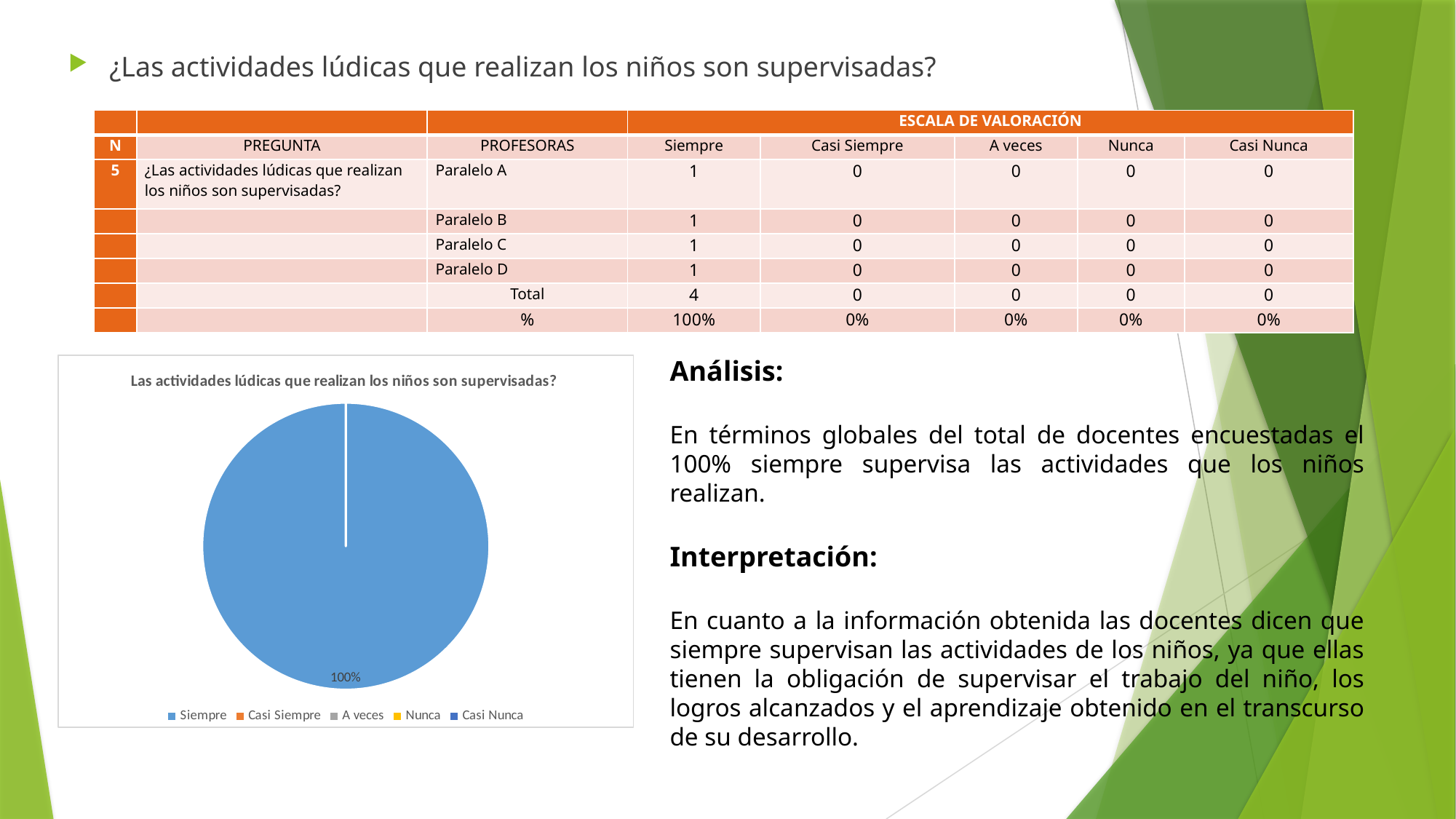
How many entries does the pie chart's legend list? 5 What percentage label is printed on the pie chart? 100% Which category has the largest slice in the pie chart? Siempre Is the share for Siempre greater or less than 50%? greater What share of the pie does the Siempre slice represent? 100% What kind of chart is shown on the slide? pie chart How many visible slices does the pie chart have? 1 Which legend entry is shown in blue in the pie chart? Siempre What is the title of the pie chart? Las actividades lúdicas que realizan los niños son supervisadas?